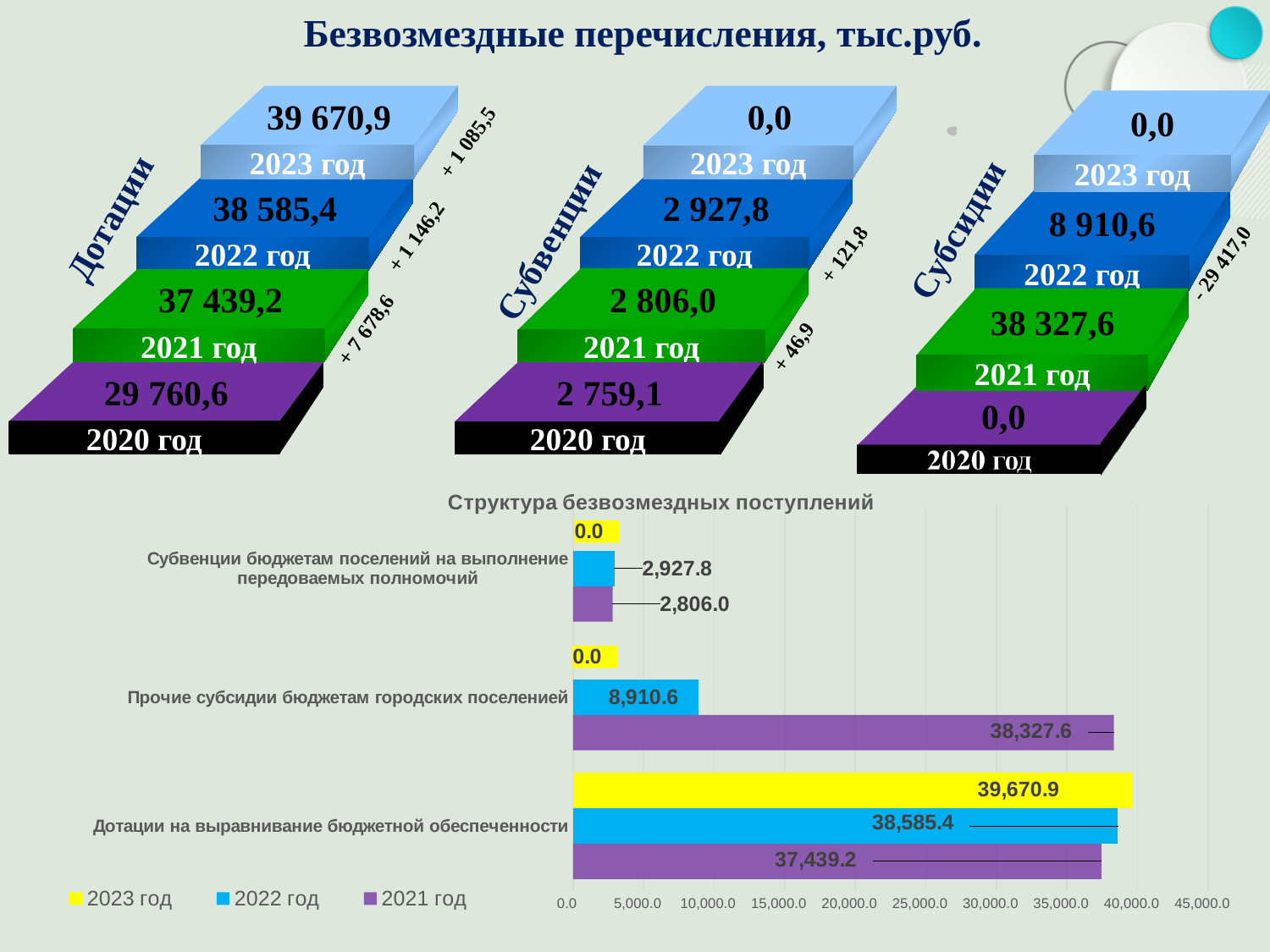
What kind of chart is 'Структура безвозмездных поступлений'? Bar chart In the chart 'Структура безвозмездных поступлений', what is the value for 'Субвенции бюджетам поселений на выполнение передоваемых полномочий' in the 2021 год series? 2,806.0 In the chart 'Структура безвозмездных поступлений', what is the difference between the 2023 год and 2022 год values for 'Дотации на выравнивание бюджетной обеспеченности'? 1,085.5 In the chart 'Структура безвозмездных поступлений', which category has the lowest value in the 2022 год series? Субвенции бюджетам поселений на выполнение передоваемых полномочий In the chart 'Структура безвозмездных поступлений', what is the difference between the 2021 год and 2022 год values for 'Прочие субсидии бюджетам городских поселений'? 29,417.0 How many categories are shown in the chart 'Структура безвозмездных поступлений'? 3 How many series does the legend of the chart 'Структура безвозмездных поступлений' list? 3 In the chart 'Структура безвозмездных поступлений', which category has the highest value in the 2021 год series? Прочие субсидии бюджетам городских поселений In the chart 'Структура безвозмездных поступлений', which is larger for 'Субвенции бюджетам поселений на выполнение передоваемых полномочий': the 2022 год value or the 2021 год value? 2022 год In the chart 'Структура безвозмездных поступлений', is the 2021 год value for 'Дотации на выравнивание бюджетной обеспеченности' greater or less than 35,000.0? greater In the chart 'Структура безвозмездных поступлений', what is the value for 'Прочие субсидии бюджетам городских поселений' in the 2022 год series? 8,910.6 In the chart 'Структура безвозмездных поступлений', what is the value for 'Дотации на выравнивание бюджетной обеспеченности' in the 2023 год series? 39,670.9